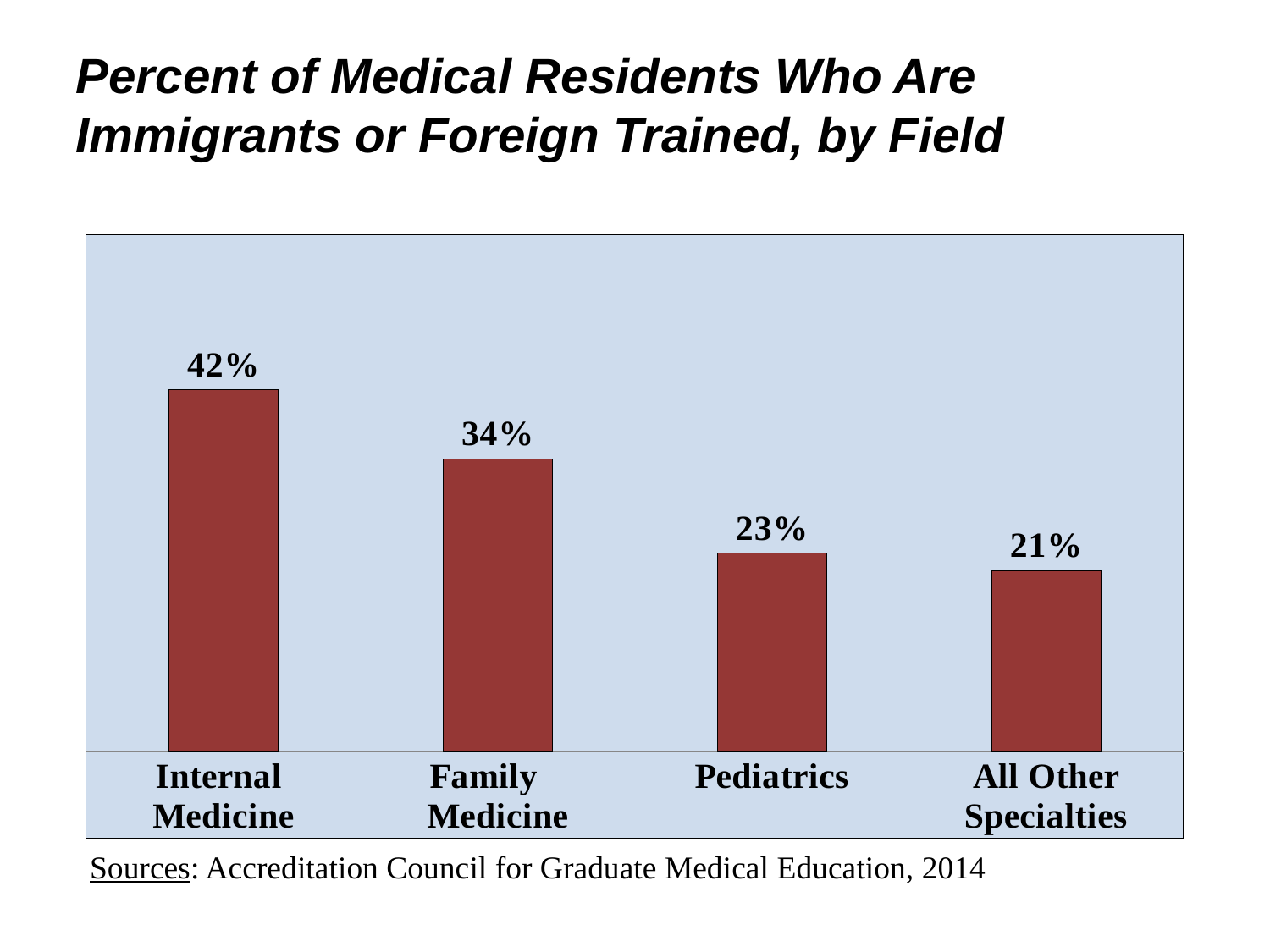
What percent of Internal Medicine residents are immigrants or foreign trained? 42% What is the value shown for Pediatrics? 23% Which field has the highest percent of residents who are immigrants or foreign trained? Internal Medicine How many fields are shown in the chart? 4 What is the difference in percentage points between Internal Medicine and Family Medicine? 8 What is the value shown for All Other Specialties? 21% Which field has the lowest percent of residents who are immigrants or foreign trained? All Other Specialties What is the value shown for Family Medicine? 34% What is the difference in percentage points between Pediatrics and All Other Specialties? 2 What kind of chart is shown on the slide? Bar chart Which is larger, the value for Family Medicine or the value for Pediatrics? Family Medicine Do the values rise or fall moving from left to right across the fields? Fall